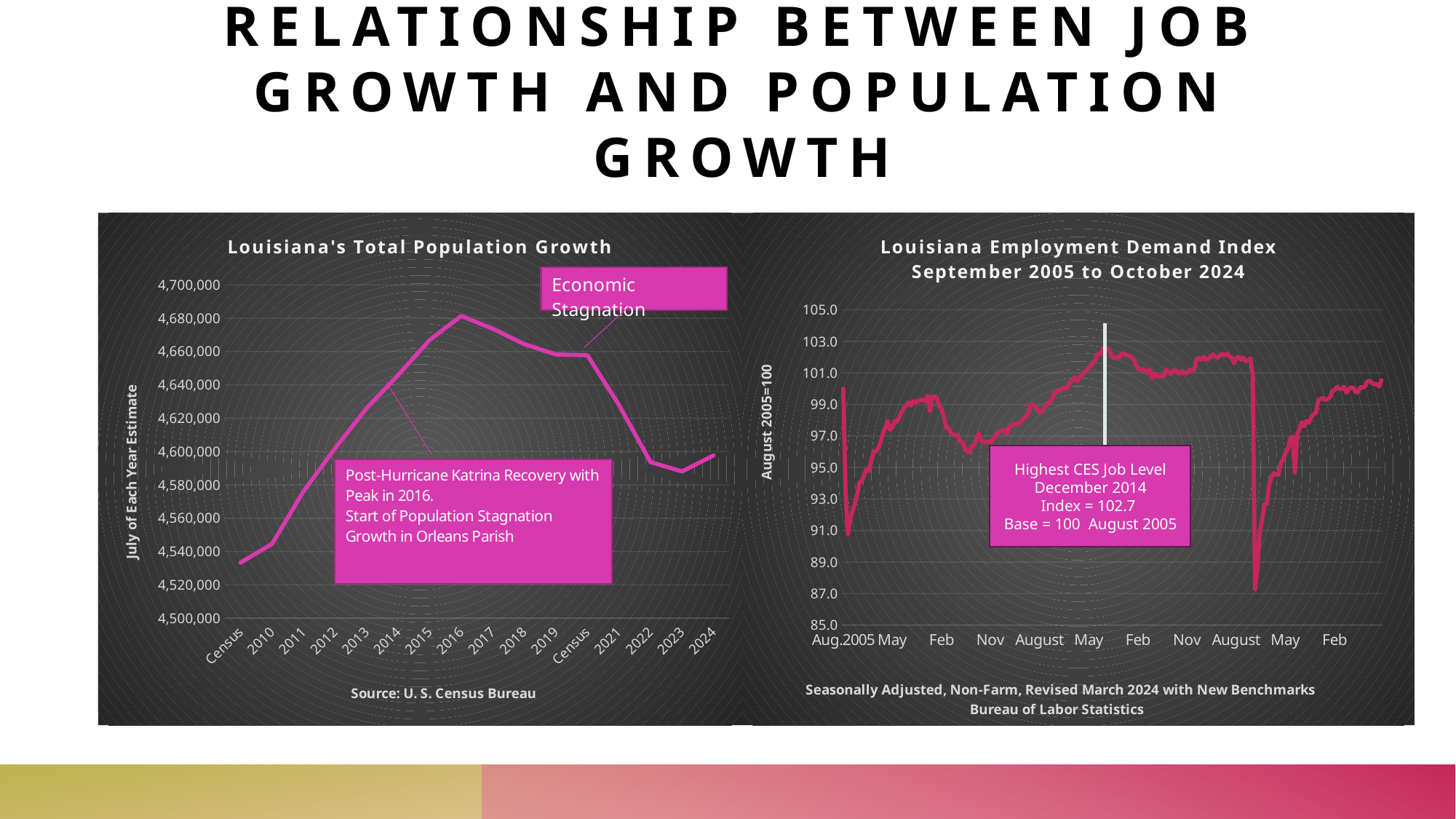
In the "Louisiana's Total Population Growth" chart, is the value for 2023 greater or less than 4,600,000? less In the "Louisiana's Total Population Growth" chart, which is larger, the value for 2016 or the value for 2023? 2016 What kind of chart is "Louisiana's Total Population Growth"? line chart In the "Louisiana's Total Population Growth" chart, which year has the highest population estimate? 2016 In the "Louisiana Employment Demand Index" chart, what index value is given for the highest CES job level in December 2014? 102.7 What is the source cited below the "Louisiana's Total Population Growth" chart? U. S. Census Bureau What kind of chart is "Louisiana Employment Demand Index September 2005 to October 2024"? line chart In the "Louisiana Employment Demand Index" chart, is the lowest point of the line (the sharp dip near the right side) greater or less than 89.0? less In the "Louisiana's Total Population Growth" chart, is the value for 2010 greater or less than 4,560,000? less In the "Louisiana's Total Population Growth" chart, do the values rise or fall between 2010 and 2016? rise How many x-axis labels are shown in the "Louisiana's Total Population Growth" chart? 16